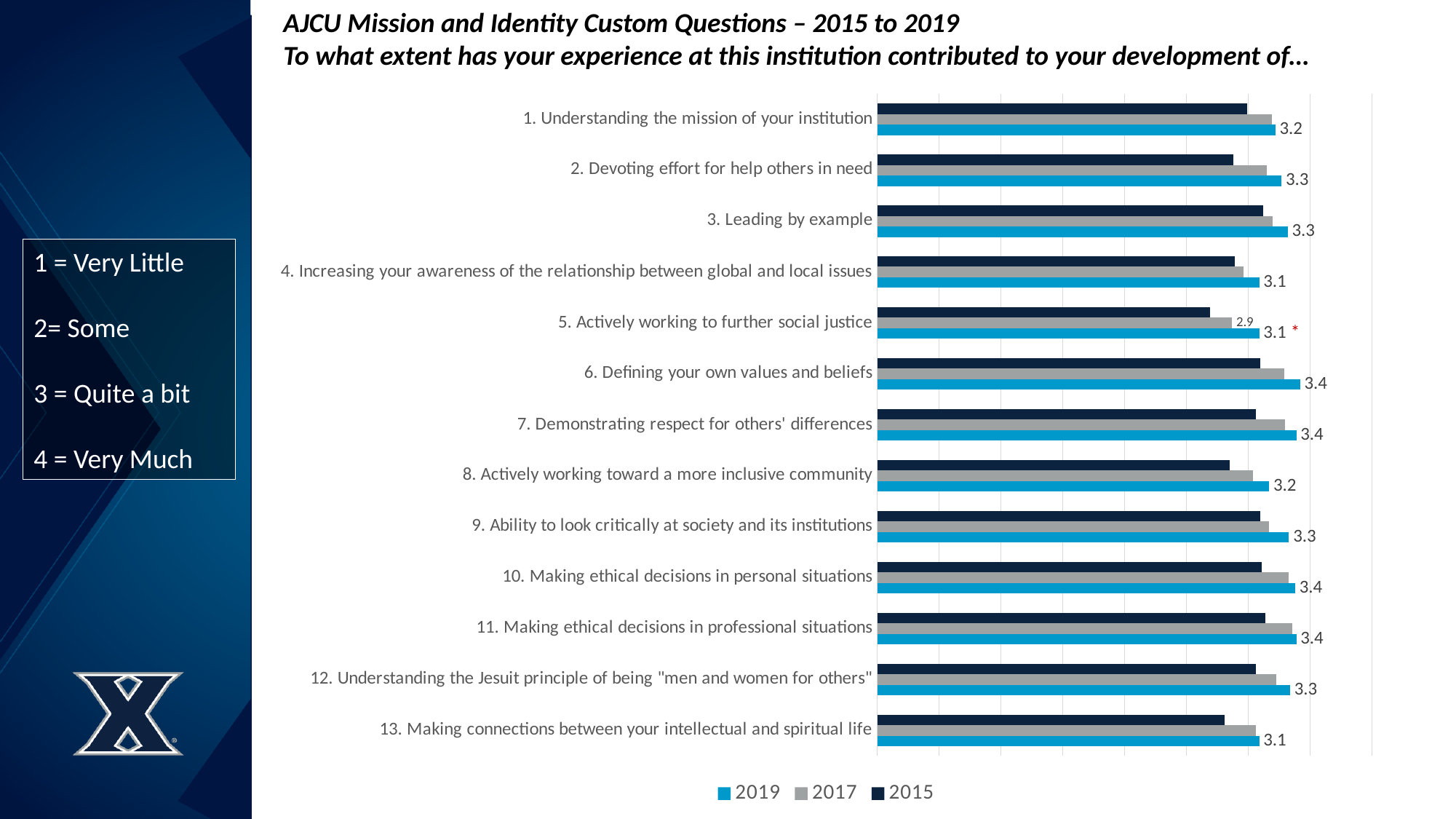
For "5. Actively working to further social justice", did the value rise or fall from 2015 to 2019? rise Which has the larger 2019 value: "2. Devoting effort for help others in need" or "8. Actively working toward a more inclusive community"? 2. Devoting effort for help others in need What is the 2019 value for "6. Defining your own values and beliefs"? 3.4 What is the 2019 value for "13. Making connections between your intellectual and spiritual life"? 3.1 How many series does the legend list? 3 What is the difference between the 2019 value for "6. Defining your own values and beliefs" and the 2019 value for "13. Making connections between your intellectual and spiritual life"? 0.3 What is the 2017 value for "5. Actively working to further social justice"? 2.9 How many questions (categories) are plotted on the chart? 13 For "5. Actively working to further social justice", what is the difference between the 2019 value and the 2017 value? 0.2 What kind of chart is shown on the slide? bar chart Which years are listed in the chart legend? 2019, 2017, 2015 What is the 2019 value for "1. Understanding the mission of your institution"? 3.2